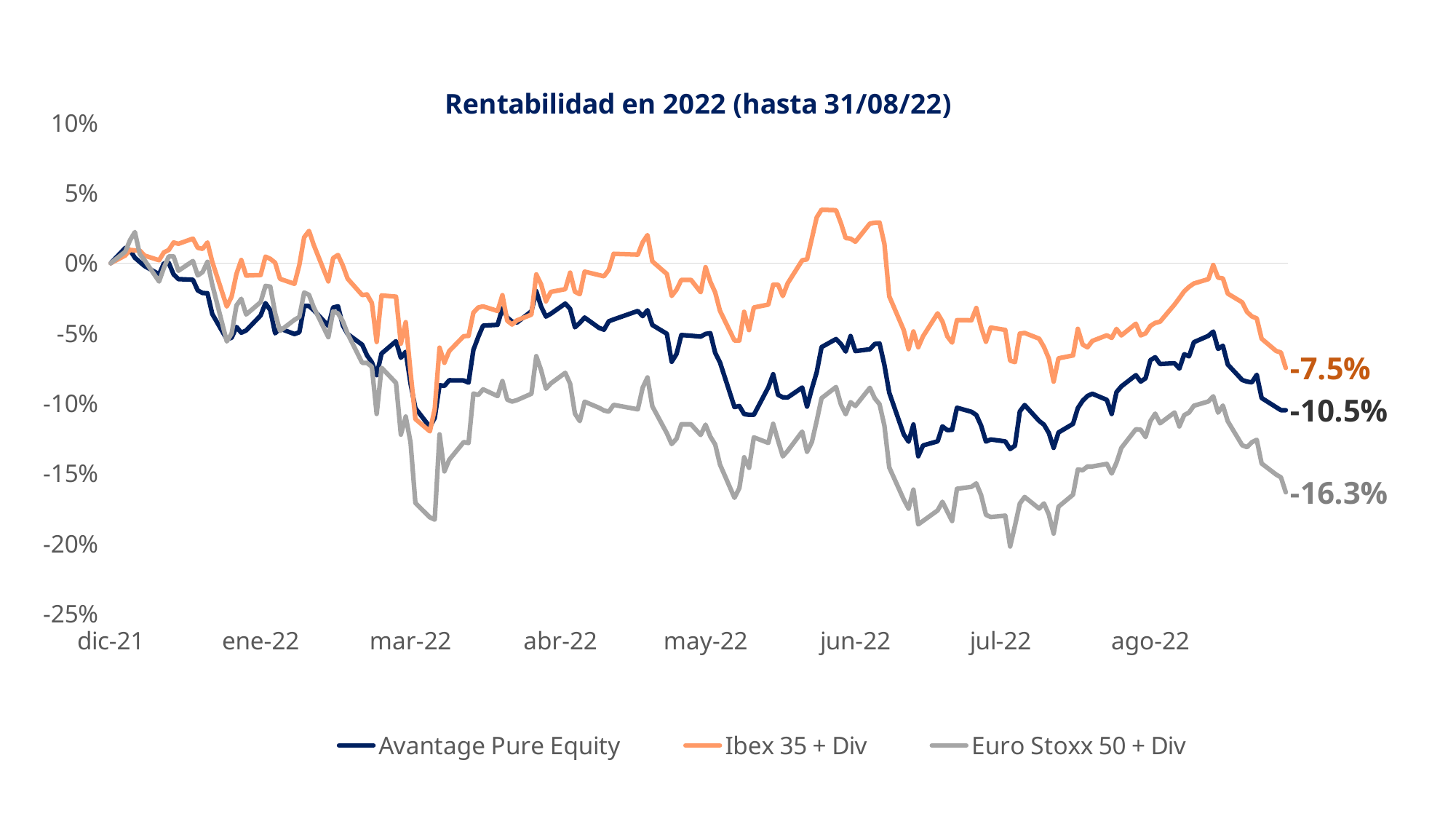
What is the final value shown for Euro Stoxx 50 + Div at the end of the chart? -16.3% What is the final value shown for Avantage Pure Equity at the end of the chart? -10.5% Which has a higher final value, Avantage Pure Equity or Euro Stoxx 50 + Div? Avantage Pure Equity Do the values for Euro Stoxx 50 + Div generally rise or fall from dic-21 to ago-22? Fall What is the difference between the final values of Ibex 35 + Div and Avantage Pure Equity? 3 percentage points How many series does the legend list? 3 What is the final value shown for Ibex 35 + Div at the end of the chart? -7.5% Which series has the highest final value at the end of the chart? Ibex 35 + Div Which series has the lowest final value at the end of the chart? Euro Stoxx 50 + Div What is the title of the chart? Rentabilidad en 2022 (hasta 31/08/22) What is the difference between the final values of Avantage Pure Equity and Euro Stoxx 50 + Div? 5.8 percentage points What kind of chart is shown on the slide? Line chart